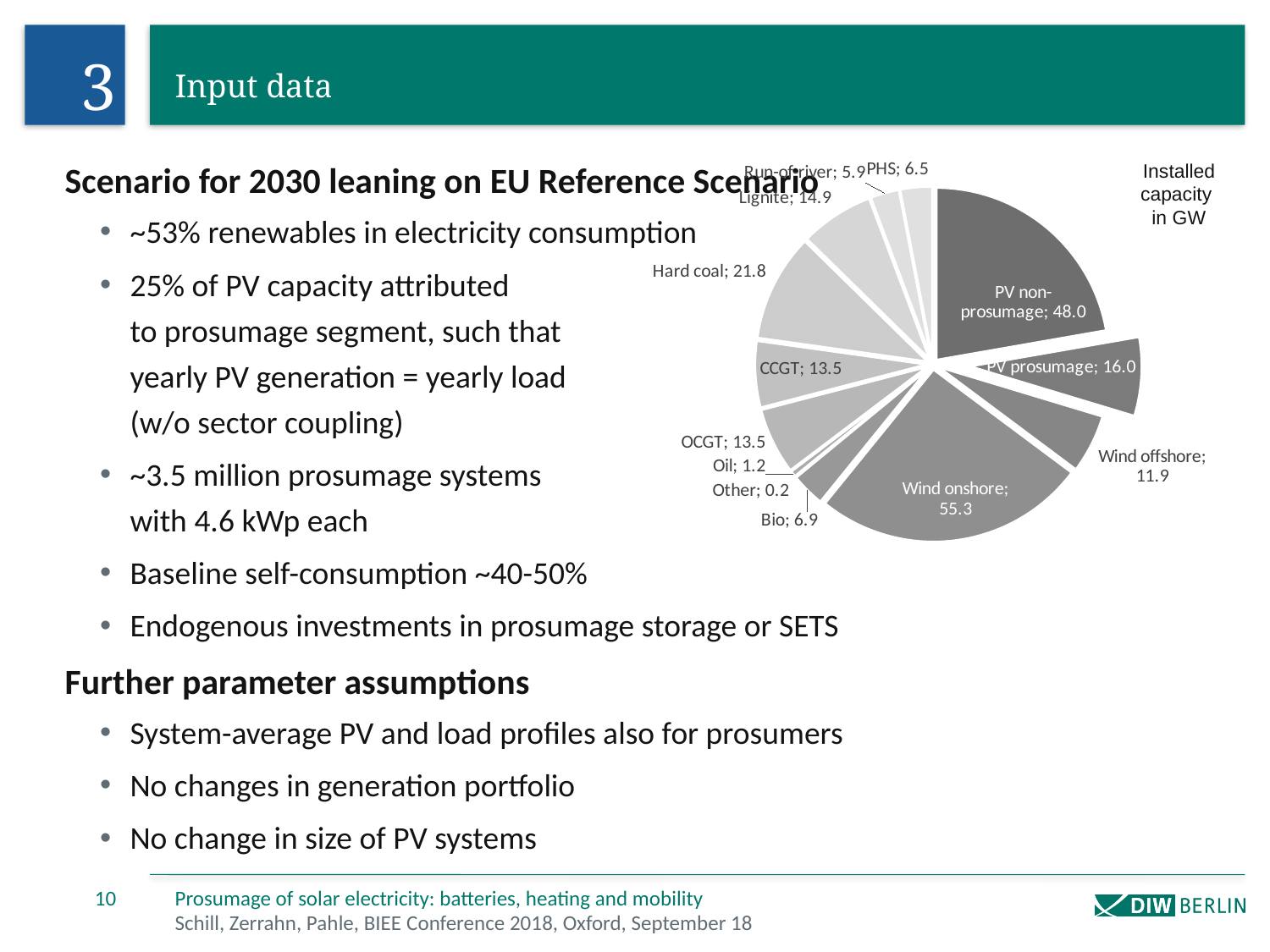
Which category has the largest installed capacity in the pie chart? Wind onshore What is the installed capacity for Wind onshore? 55.3 Which category has the smallest installed capacity in the pie chart? Other How many categories are shown in the pie chart? 13 Which has a larger installed capacity, Wind offshore or Lignite? Lignite What is the difference in installed capacity between PV non-prosumage and PV prosumage? 32.0 What is the difference in installed capacity between Hard coal and Lignite? 6.9 What is the installed capacity for PV non-prosumage? 48.0 What is the installed capacity for Hard coal? 21.8 In what unit is the installed capacity in the pie chart given? GW What type of chart is shown on the slide? pie chart What is the installed capacity for PHS? 6.5